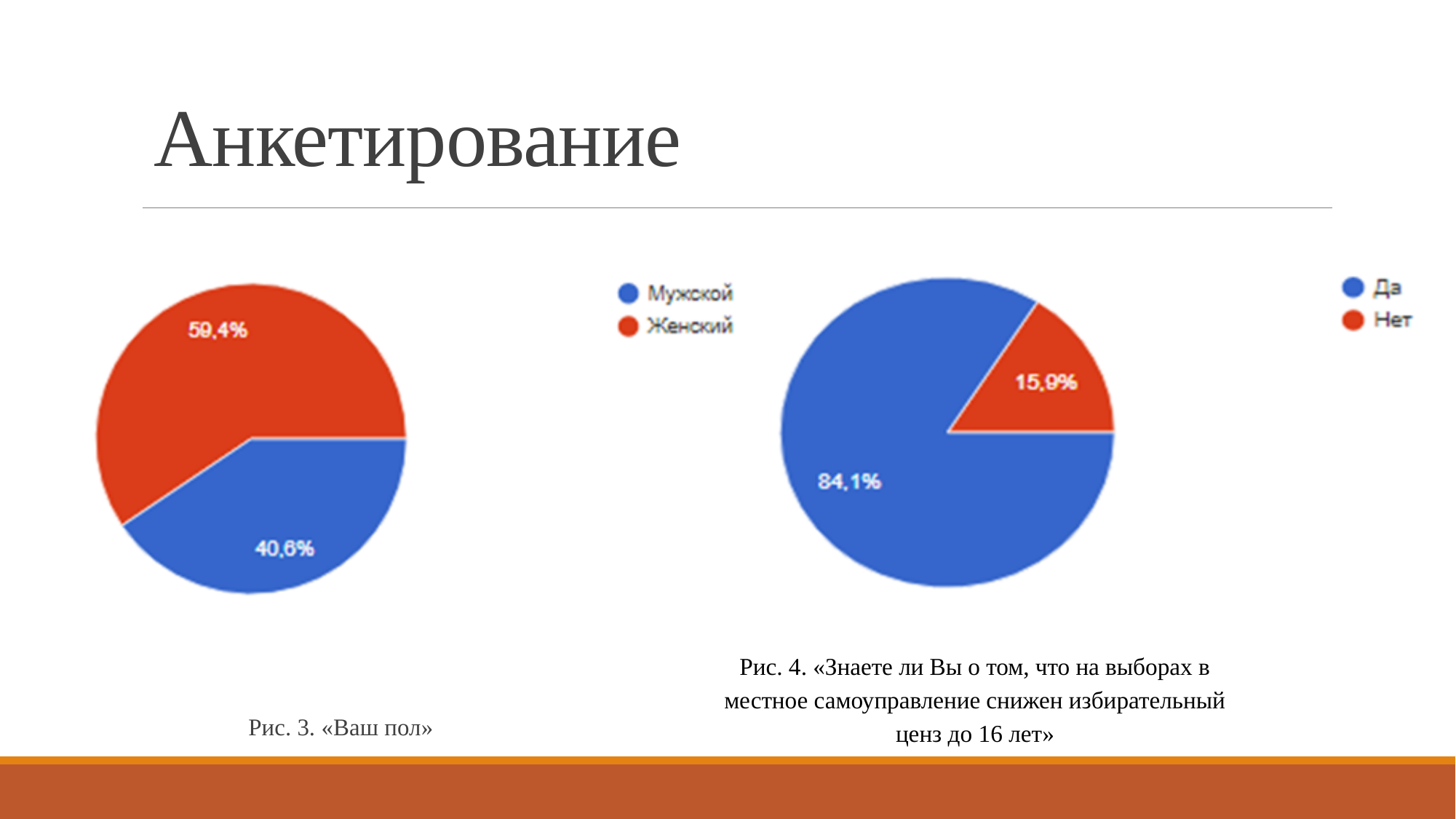
How many slices does the left chart (Рис. 3. «Ваш пол») have? 2 In the right chart (Рис. 4), what is the difference in percentage points between Да and Нет? 68,2 In the right chart (Рис. 4), what share of respondents answered Да? 84,1% What type of chart is used in Рис. 4? Pie chart In the left chart (Рис. 3. «Ваш пол»), which category has the larger slice? Женский In the left chart (Рис. 3. «Ваш пол»), what share of respondents is Мужской? 40,6% In the left chart (Рис. 3. «Ваш пол»), what share of respondents is Женский? 59,4% In the right chart (Рис. 4), what colour is the slice for Нет? Red In the left chart (Рис. 3. «Ваш пол»), what is the difference in percentage points between Женский and Мужской? 18,8 In the right chart (Рис. 4), which answer has the smallest slice? Нет In the right chart (Рис. 4), which is larger: Да or Нет? Да In the right chart (Рис. 4), what share of respondents answered Нет? 15,9%